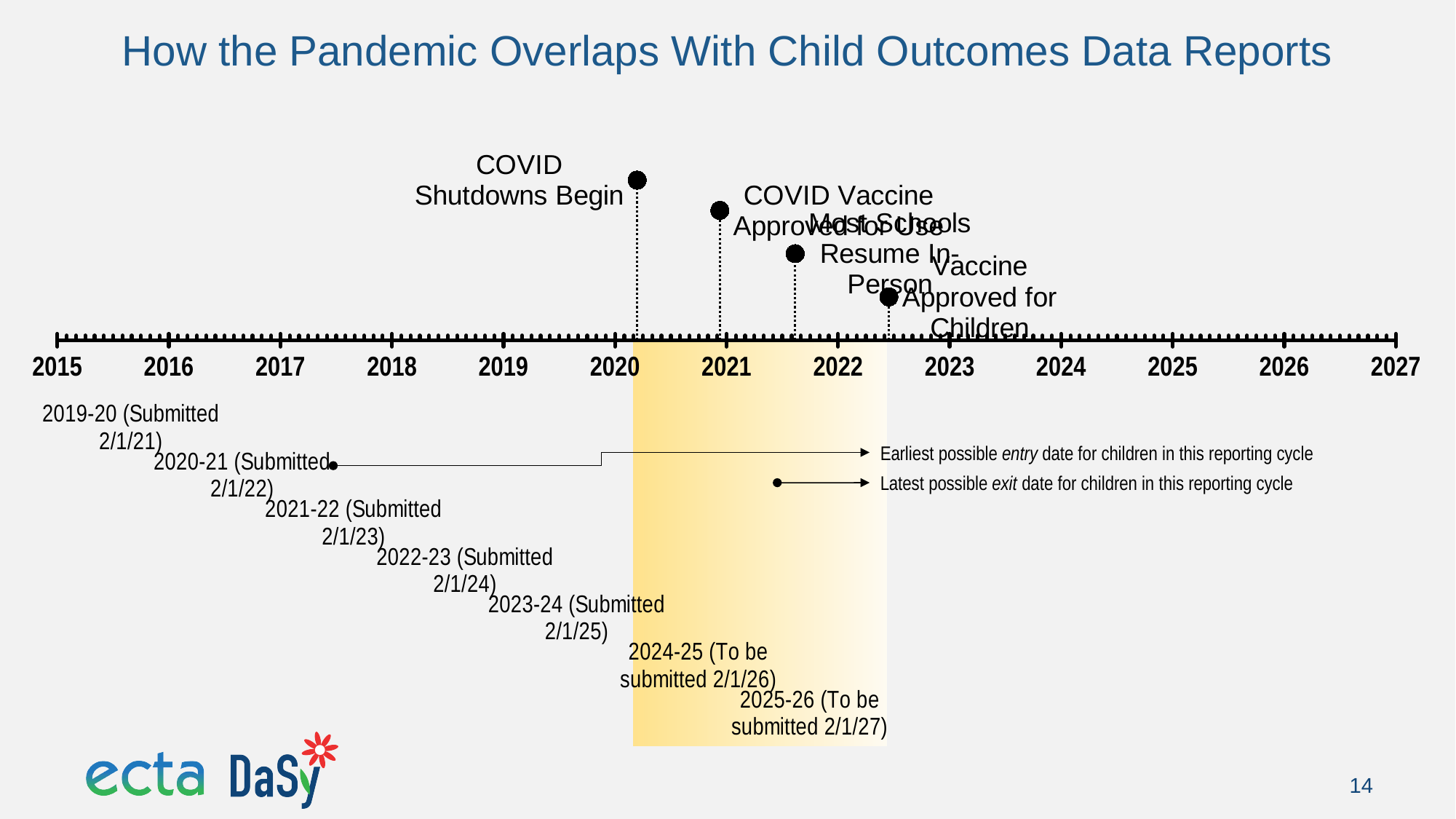
How many pandemic events are marked with dots above the timeline? 4 What is the title of the chart on the slide? How the Pandemic Overlaps With Child Outcomes Data Reports Which reporting cycle was submitted on 2/1/21? 2019-20 How many reporting cycles are listed below the timeline? 7 When is the 2025-26 reporting cycle to be submitted, according to the slide? 2/1/27 What is the last year shown on the timeline axis? 2027 Is the COVID Shutdowns Begin marker placed before or after 2019 on the timeline? after When was the 2021-22 reporting cycle submitted, according to the slide? 2/1/23 What kind of chart is shown on the slide? A timeline Which pandemic event is marked earliest on the timeline? COVID Shutdowns Begin Which pandemic event is marked latest on the timeline? Vaccine Approved for Children What is the first year shown on the timeline axis? 2015